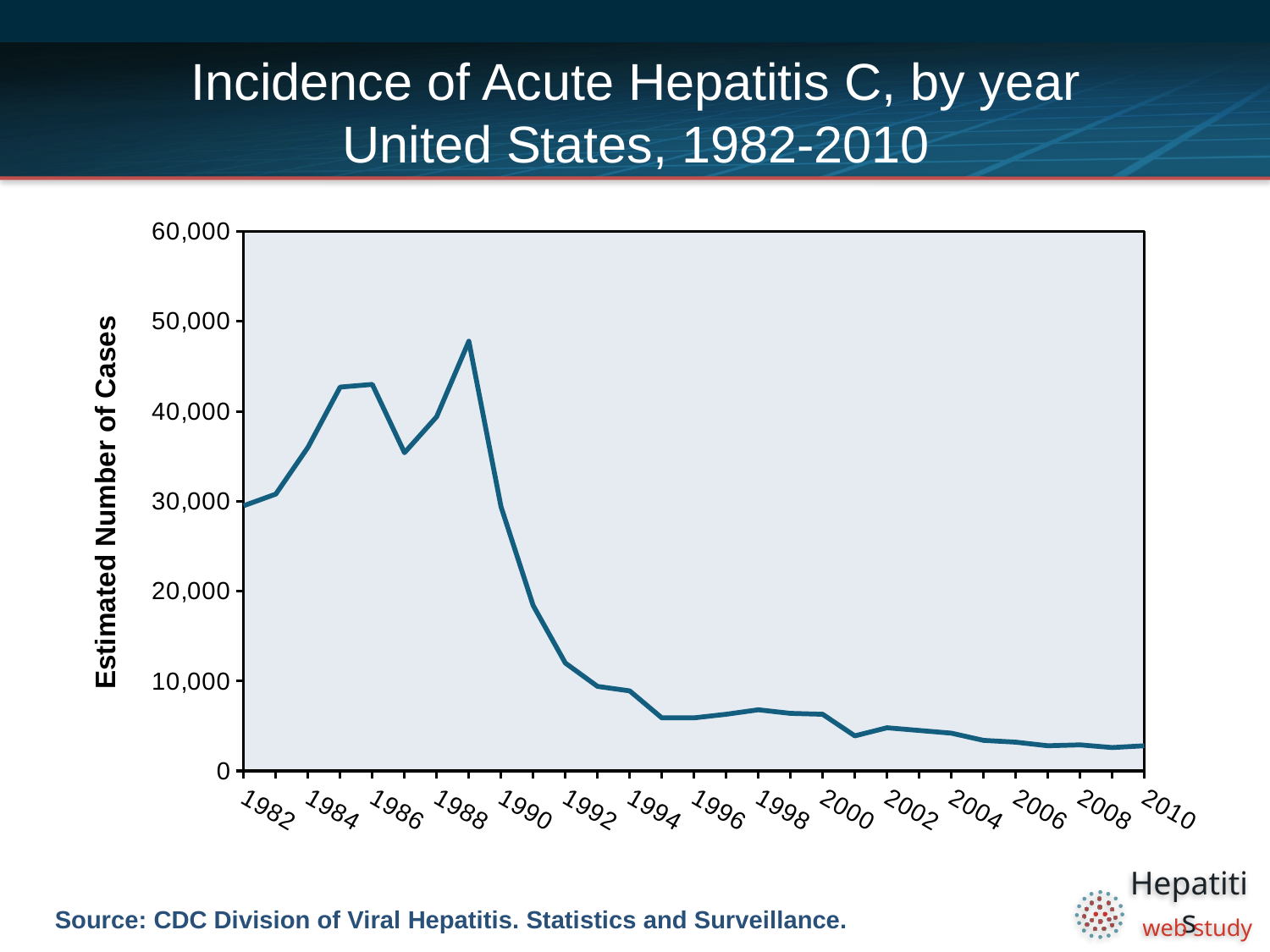
Which year had more estimated cases, 1986 or 1990? 1986 What is the title of the chart on the slide? Incidence of Acute Hepatitis C, by year United States, 1982-2010 Which year had more estimated cases, 1984 or 2010? 1984 Is the estimated number of cases in 2010 greater or less than 10,000? less Is the estimated number of cases in 1986 greater or less than 40,000? greater Is the estimated number of cases in 1984 greater or less than 40,000? less How many year labels are shown on the x axis? 15 What kind of chart is shown on the slide? line chart What is the label on the vertical axis of the chart? Estimated Number of Cases Do the estimated number of cases rise or fall between 1990 and 2010? fall